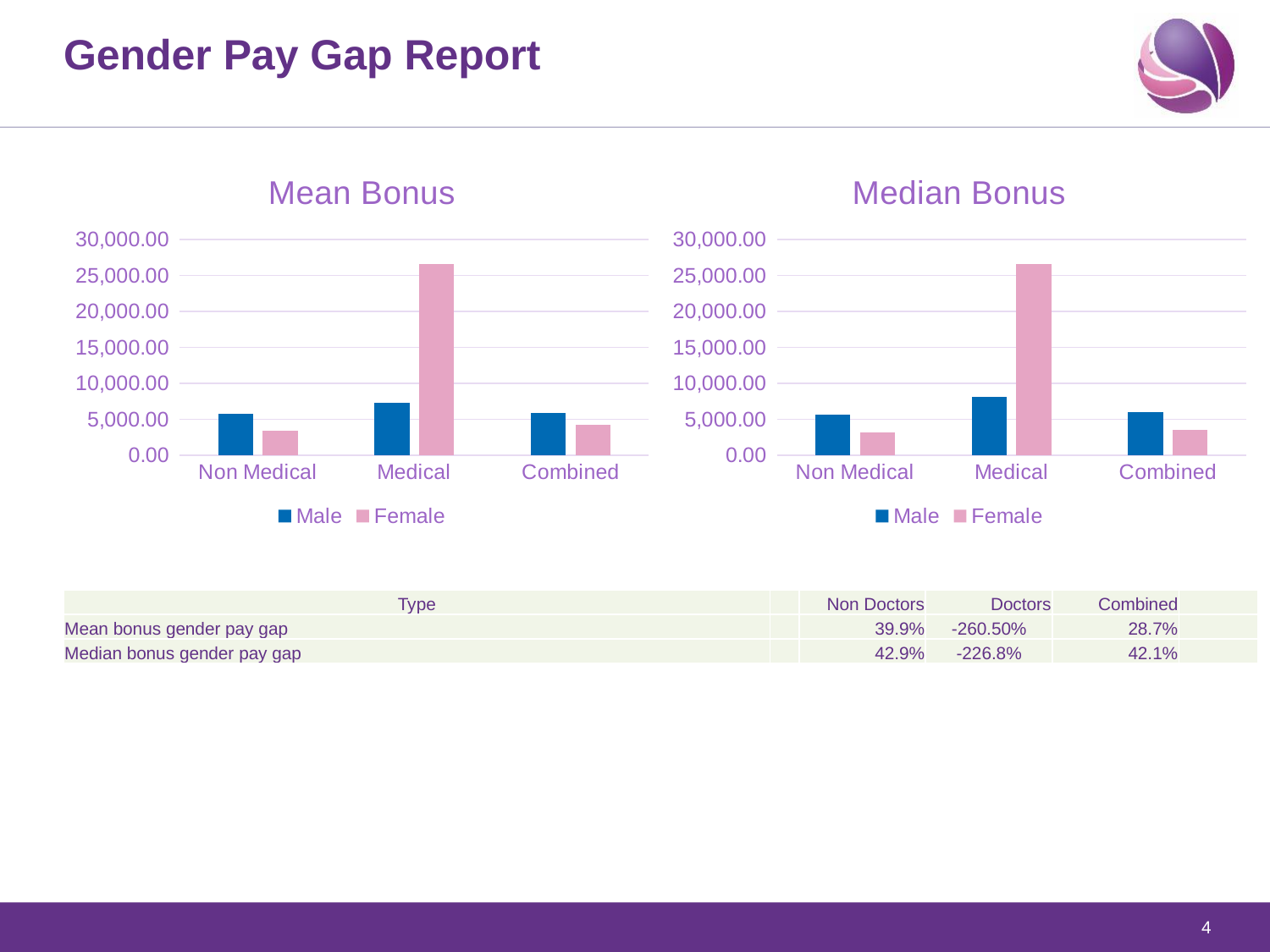
In the Mean Bonus chart, which is larger for Combined: the Male value or the Female value? Male In the Median Bonus chart, is the Male value for Medical greater or less than 10,000.00? less In the Median Bonus chart, which category has the highest Male value? Medical In the Mean Bonus chart, is the Female value for Medical greater or less than 25,000.00? greater What are the two series named in the legend of the Median Bonus chart? Male and Female What kind of chart is the Mean Bonus chart? bar chart In the Mean Bonus chart, which category has the highest Female value? Medical In the Median Bonus chart, which is larger for Medical: the Male value or the Female value? Female In the Median Bonus chart, which category has the lowest Female value? Non Medical In the Mean Bonus chart, is the Female value for Non Medical greater or less than 5,000.00? less How many categories are shown on the x axis of the Median Bonus chart? 3 How many series does the legend of the Mean Bonus chart list? 2